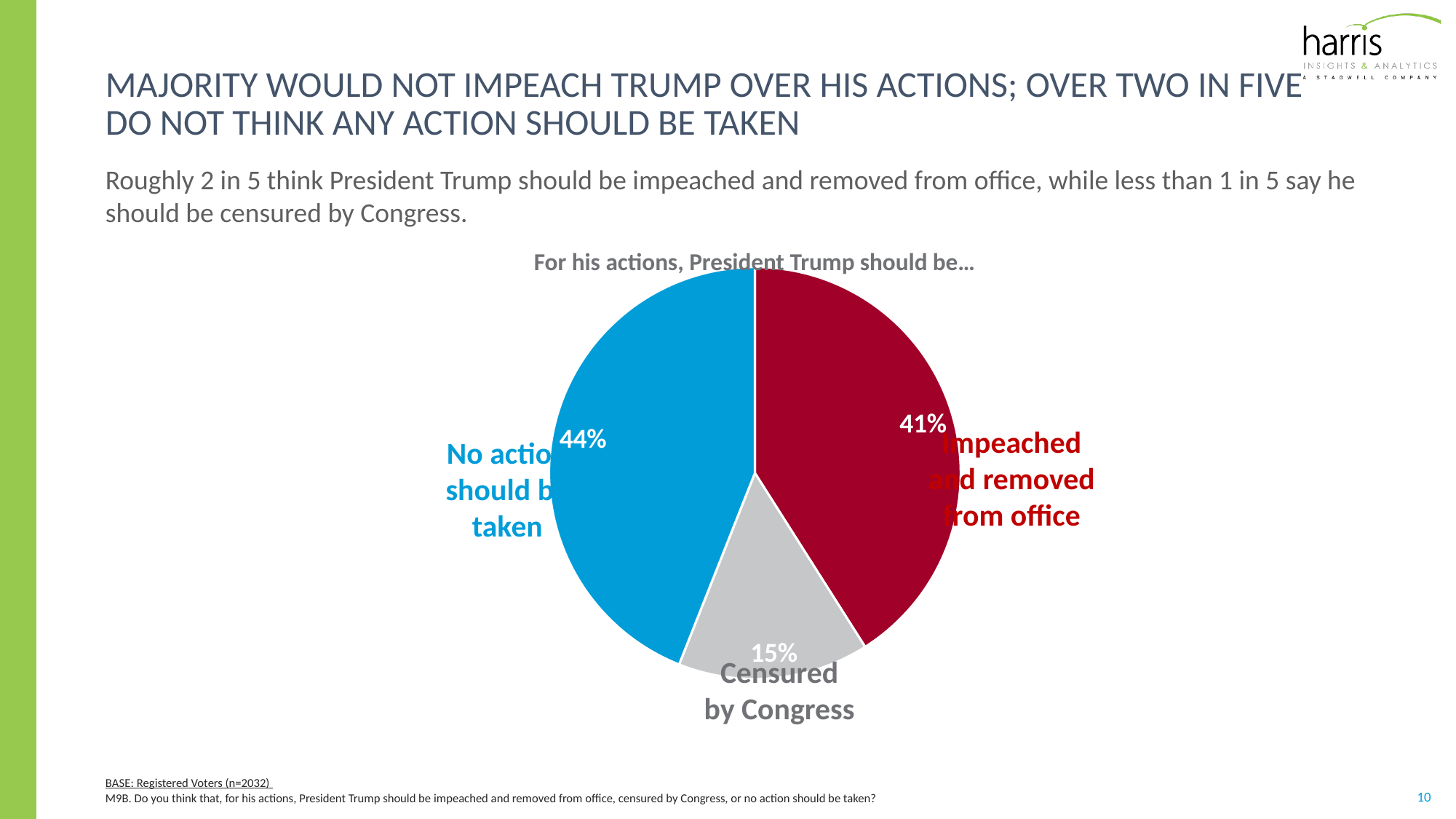
What percentage of respondents say no action should be taken? 44% Which is larger: the share for 'Impeached and removed from office' or the share for 'Censured by Congress'? Impeached and removed from office What is the difference in percentage points between 'Impeached and removed from office' and 'Censured by Congress'? 26 Which response has the largest share of the pie? No action should be taken What percentage of respondents say President Trump should be impeached and removed from office? 41% What percentage of respondents say President Trump should be censured by Congress? 15% How many slices does the pie chart have? 3 What kind of chart is shown on the slide? Pie chart What is the title of the chart? For his actions, President Trump should be… What is the difference in percentage points between 'No action should be taken' and 'Impeached and removed from office'? 3 Which response has the smallest share of the pie? Censured by Congress What colour is the slice for 'Censured by Congress'? Grey